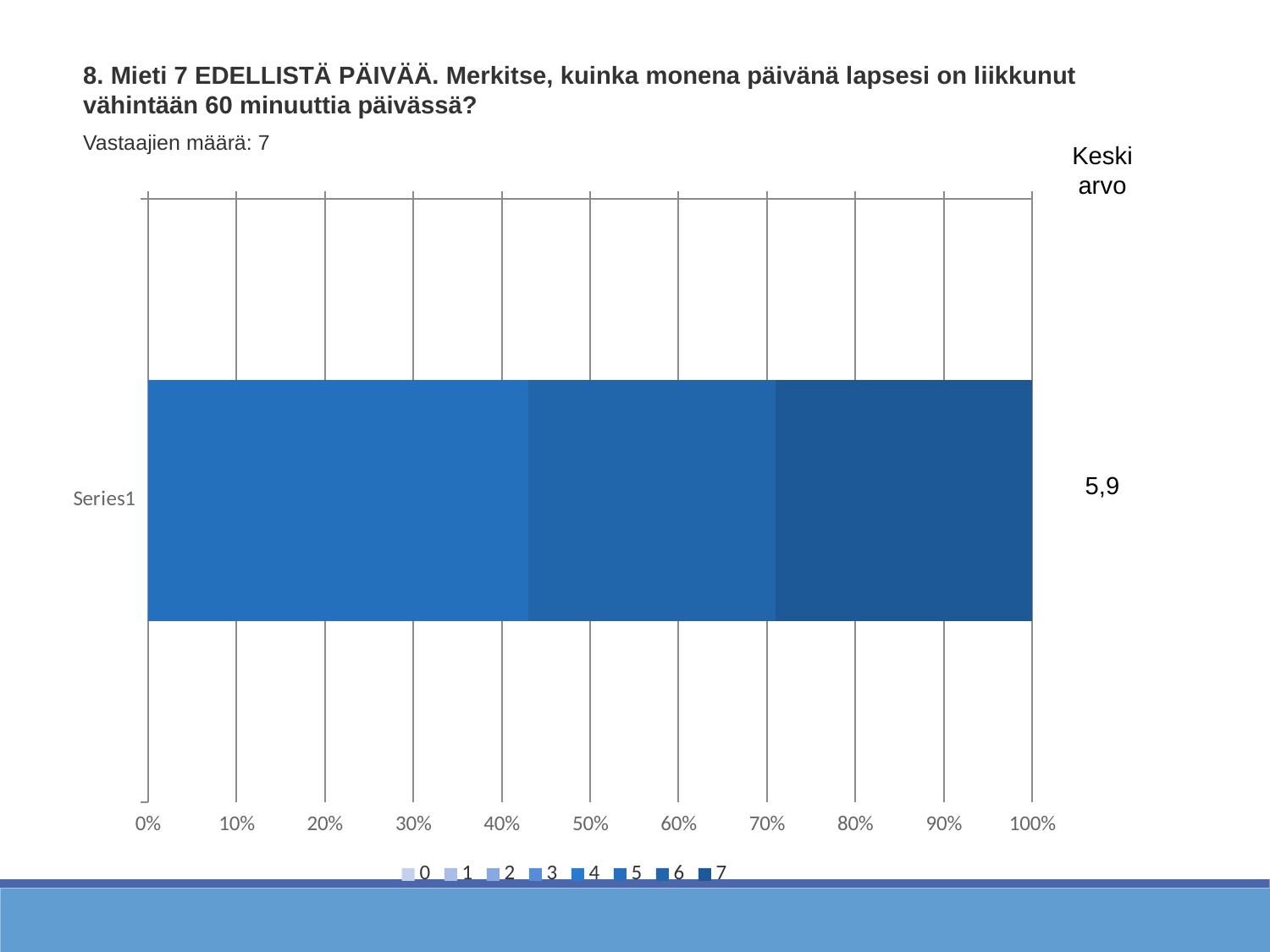
How many categories are plotted on the vertical axis of the chart? 1 What kind of chart is shown on the slide? bar chart What mean value (Keskiarvo) is printed next to the chart? 5,9 Is the end of the leftmost segment of the Series1 bar greater or less than 40%? greater What is the highest value shown on the horizontal axis of the chart? 100% How many respondents (Vastaajien määrä) are reported for this chart? 7 What is the label of the single category on the vertical axis? Series1 Is the end of the middle segment of the Series1 bar greater or less than 80%? less Is the end of the leftmost segment of the Series1 bar greater or less than 50%? less How many coloured segments are visible in the Series1 bar? 3 How many entries does the chart's legend list? 8